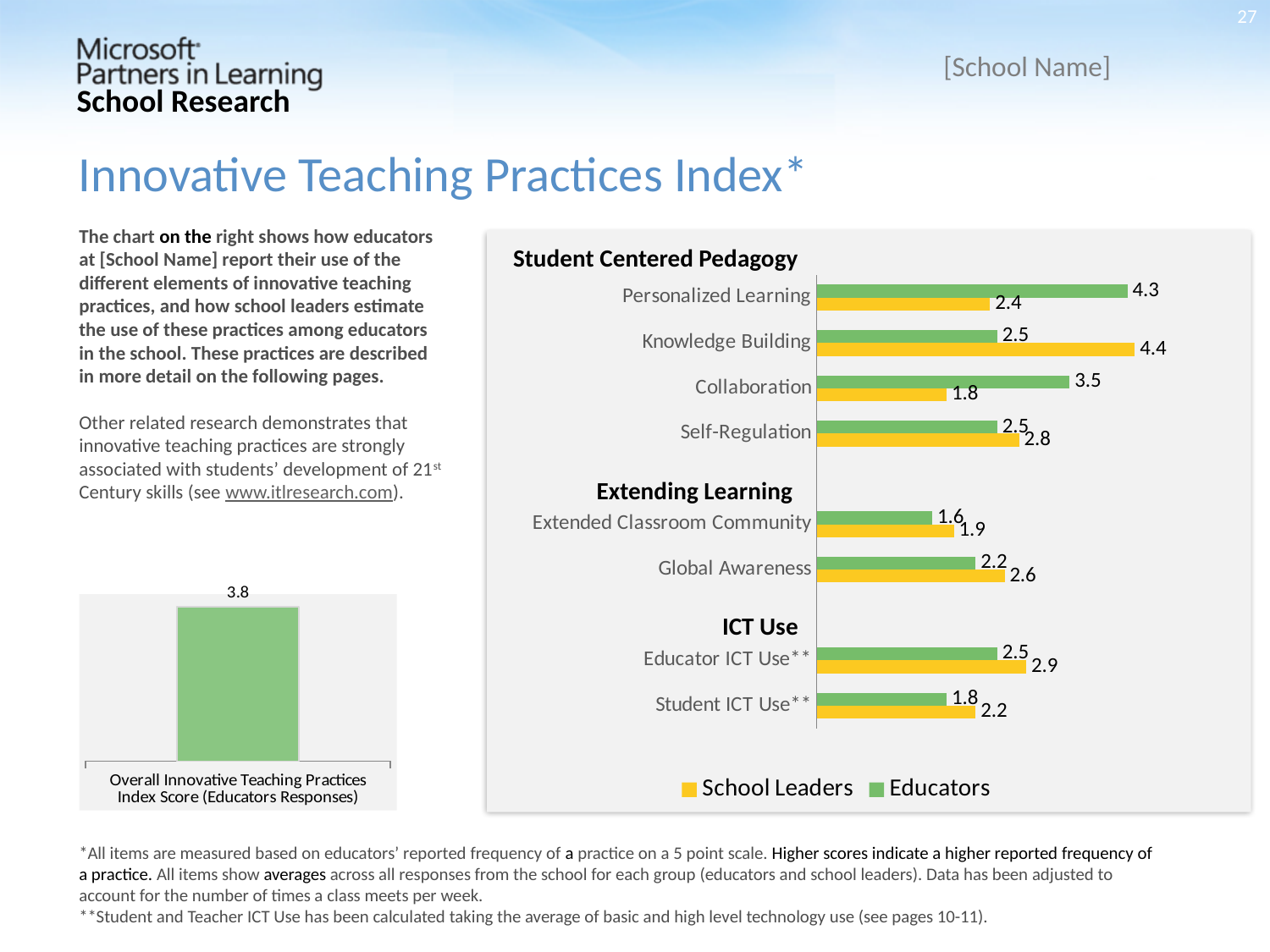
In the chart on the right, which is larger for Knowledge Building: the School Leaders value or the Educators value? School Leaders In the chart on the right, which category has the lowest Educators value? Extended Classroom Community What type of chart is the chart on the right? Bar chart In the chart on the right, which category has the highest Educators value? Personalized Learning What value is shown in the chart on the left for Overall Innovative Teaching Practices Index Score (Educators Responses)? 3.8 How many series does the legend of the chart on the right list? 2 In the chart on the right, what is the School Leaders value for Knowledge Building? 4.4 In the chart on the right, what is the School Leaders value for Collaboration? 1.8 In the chart on the right, what is the Educators value for Student ICT Use? 1.8 In the chart on the right, what is the Educators value for Personalized Learning? 4.3 How many categories are plotted in the chart on the right? 8 In the chart on the right, what is the difference between the Educators and School Leaders values for Collaboration? 1.7